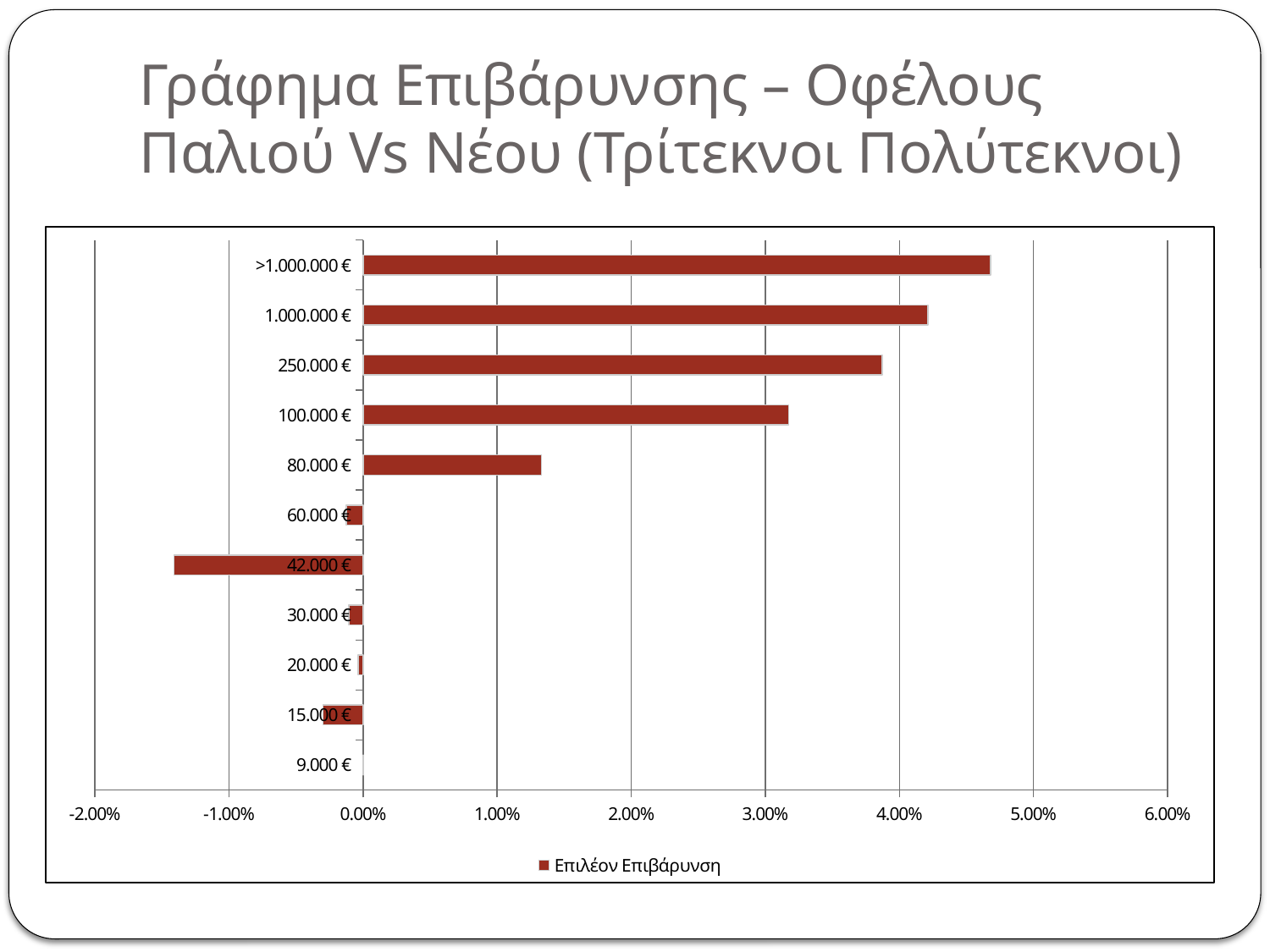
Which is larger, the value for 1.000.000 € or the value for 250.000 €? 1.000.000 € Is the value for 42.000 € greater or less than -1.00%? less What kind of chart is shown on the slide? bar chart Is the value for 100.000 € greater or less than 3.00%? greater How many series does the legend list? 1 Is the value for >1.000.000 € greater or less than 4.00%? greater What is the name of the series shown in the legend? Επιλέον Επιβάρυνση Which category has the highest value? >1.000.000 € Which is larger, the value for 80.000 € or the value for 100.000 €? 100.000 € How many income categories are plotted on the chart? 11 Which category has the lowest (most negative) value? 42.000 €